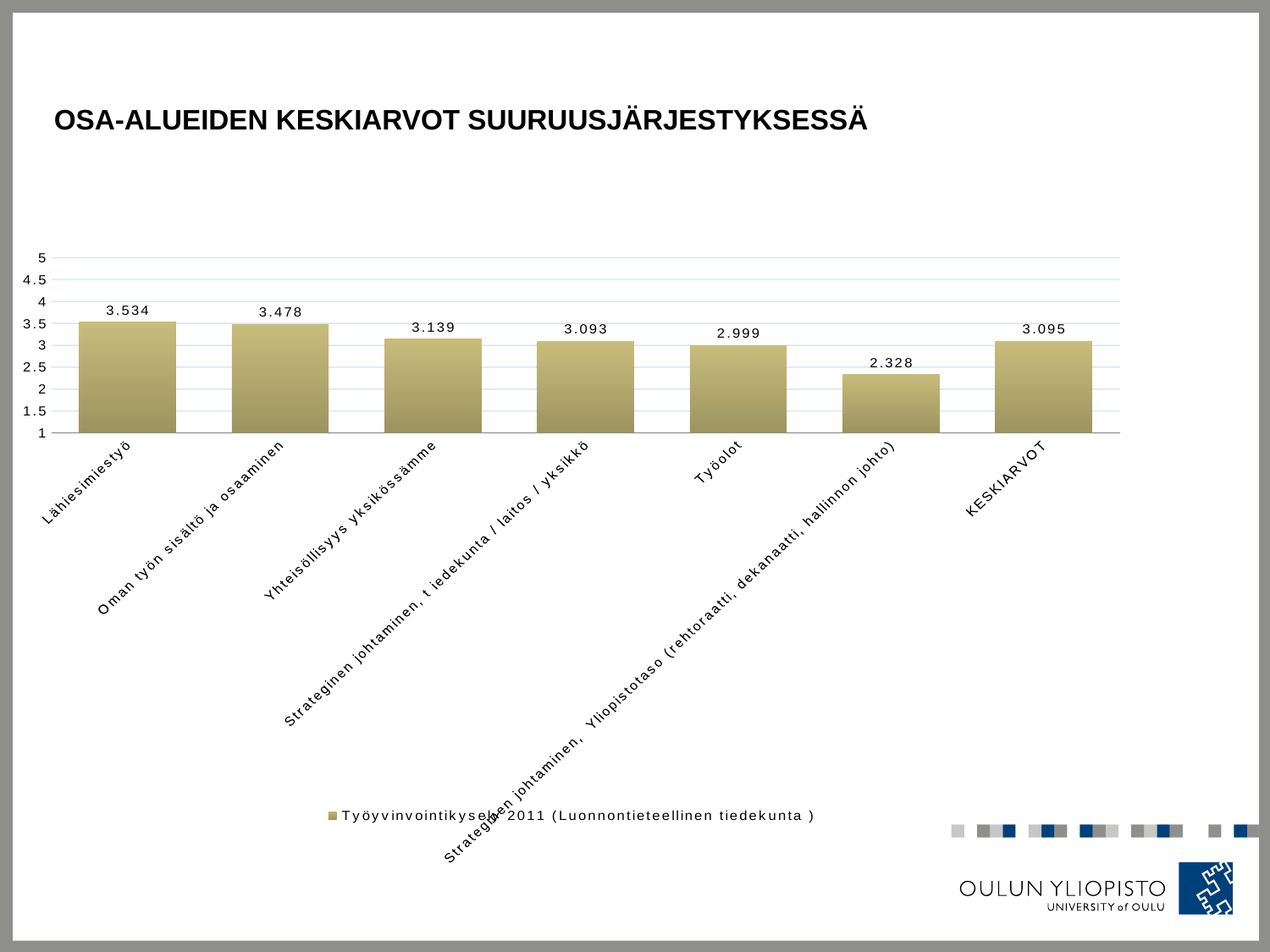
What is the value for Työolot? 2.999 Which category has the highest value? Lähiesimiestyö What is the title of the chart on the slide? OSA-ALUEIDEN KESKIARVOT SUURUUSJÄRJESTYKSESSÄ Which category has the lowest value? Strateginen johtaminen, Yliopistotaso (rehtoraatti, dekanaatti, hallinnon johto) Which is larger, the value for Työolot or the value for Yhteisöllisyys yksikössämme? Yhteisöllisyys yksikössämme What is the value for Yhteisöllisyys yksikössämme? 3.139 How many categories are shown on the x axis? 7 What is the value for KESKIARVOT? 3.095 What kind of chart is shown on the slide? Bar chart What is the value for Lähiesimiestyö? 3.534 How many series does the legend list? 1 What is the difference between the values for Lähiesimiestyö and Oman työn sisältö ja osaaminen? 0.056